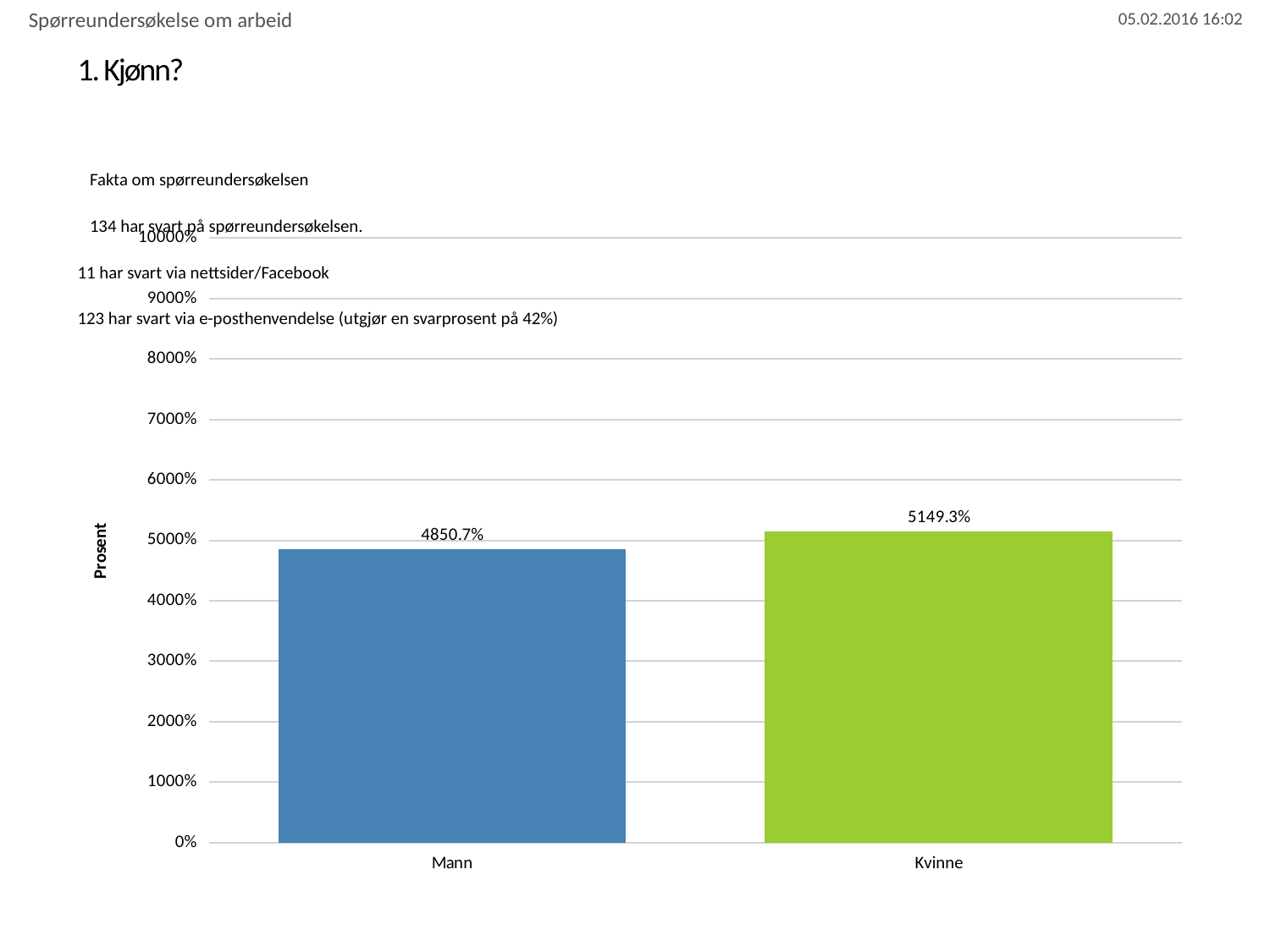
What is the value for Mann? 4850.7% What colour is the bar for Kvinne? green What kind of chart is shown on the slide? bar chart What is the difference between the values for Kvinne and Mann? 298.6% How many categories are shown on the x axis? 2 What is the label of the y axis? Prosent What is the value for Kvinne? 5149.3% Which category has the highest value? Kvinne Which is larger, the value for Mann or the value for Kvinne? Kvinne Which category has the lowest value? Mann Is the value for Mann greater or less than 5000%? less Is the value for Kvinne greater or less than 5000%? greater